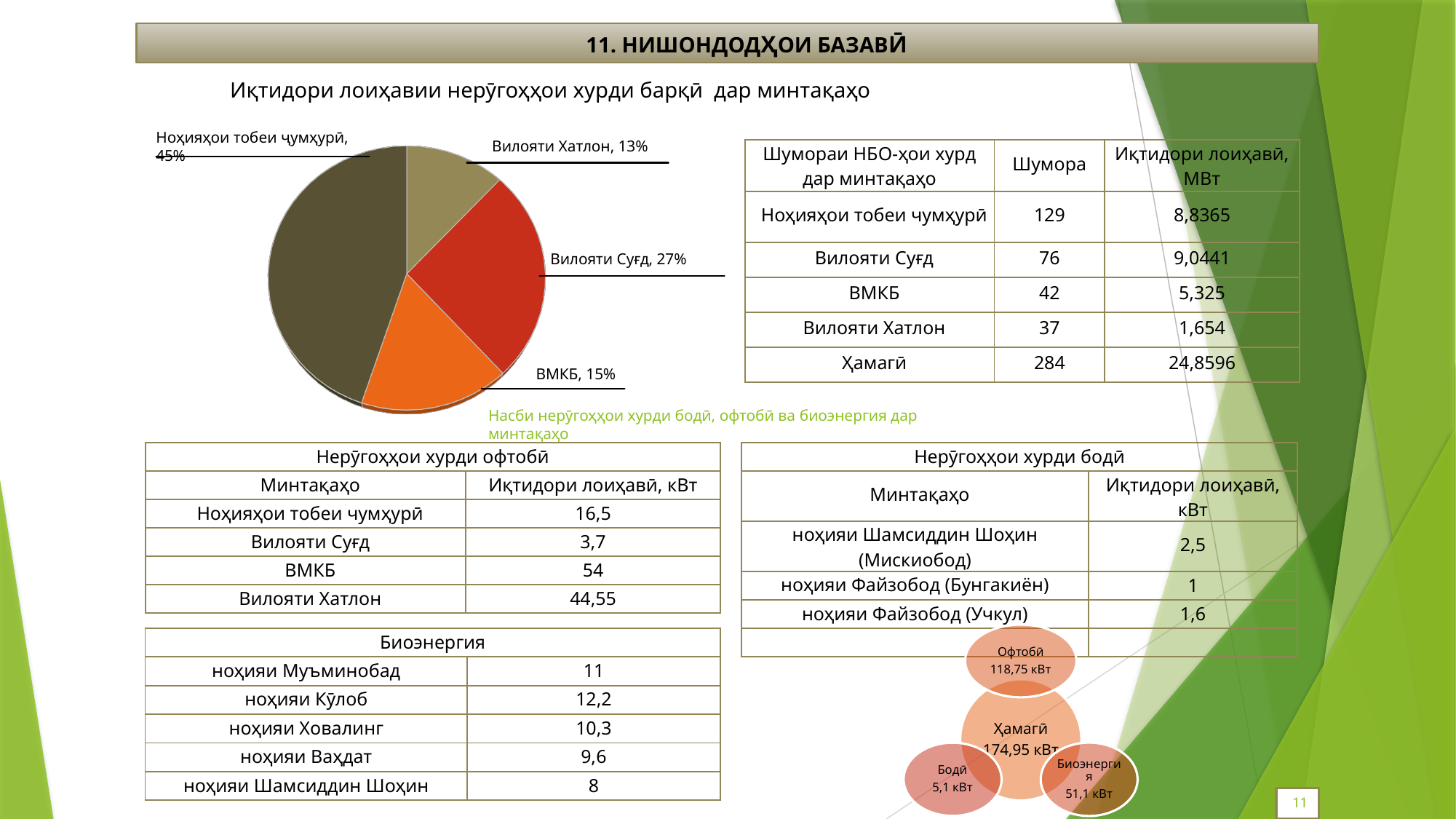
Which slice of the pie chart is the largest? Ноҳияҳои тобеи ҷумҳурӣ Which slice of the pie chart is the smallest? Вилояти Хатлон What share of the pie chart does ВМКБ hold? 15% What is the title of the pie chart? Иқтидори лоиҳавии нерӯгоҳҳои хурди барқӣ дар минтақаҳо In the pie chart, what is the difference in percentage points between Вилояти Суғд and ВМКБ? 12 What share of the pie chart does Вилояти Хатлон hold? 13% In the pie chart, which is larger: ВМКБ or Вилояти Хатлон? ВМКБ How many slices does the pie chart have? 4 What share of the pie chart does Вилояти Суғд hold? 27% What kind of chart is shown on the slide? pie chart In the pie chart, what is the difference in percentage points between Ноҳияҳои тобеи ҷумҳурӣ and Вилояти Суғд? 18